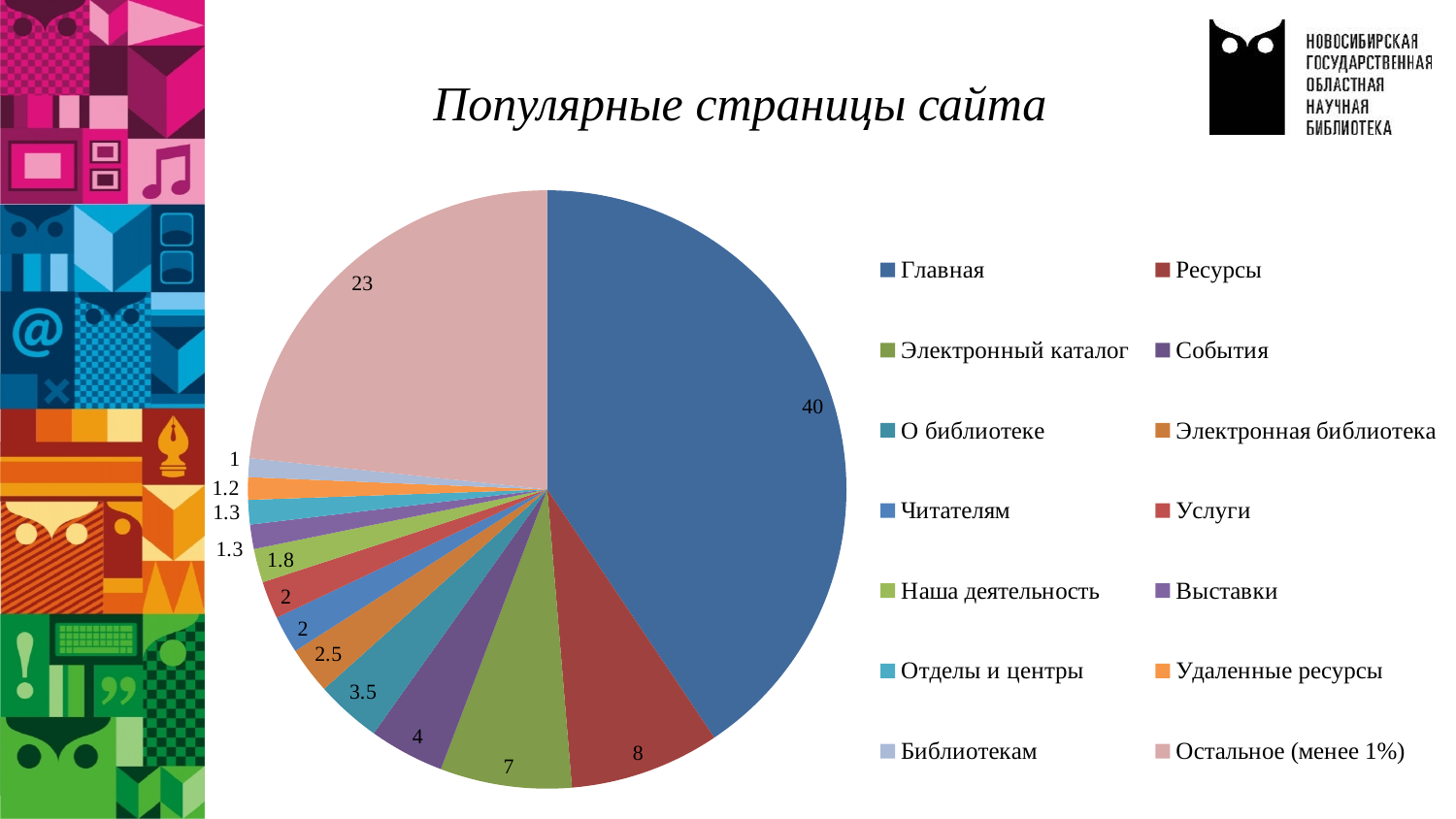
What is the title of the slide's chart? Популярные страницы сайта Which category has the smallest slice of the pie? Библиотекам Which is larger, the value for Электронный каталог or the value for События? Электронный каталог What is the difference between the values for Главная and Ресурсы? 32 What value is shown for the О библиотеке slice? 3.5 What value is shown for the Электронный каталог slice? 7 What value is shown for the Ресурсы slice? 8 What value is shown for the Остальное (менее 1%) slice? 23 Which category has the largest slice of the pie? Главная What value is shown for the Главная slice? 40 What type of chart is shown on the slide? Pie chart How many categories does the pie chart have? 14